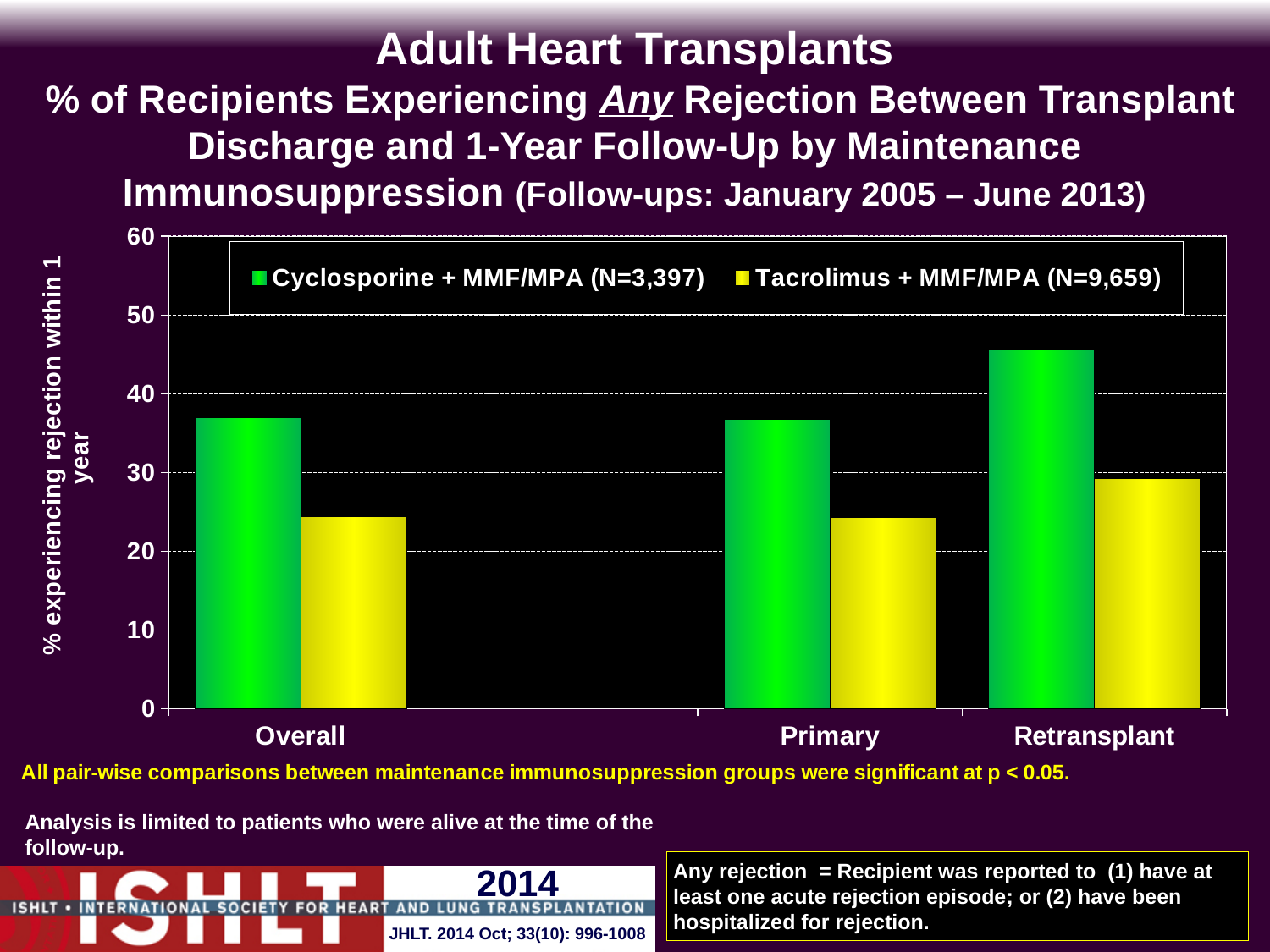
Which category has the highest value for Tacrolimus + MMF/MPA? Retransplant In the Overall group, which series has the larger value, Cyclosporine + MMF/MPA or Tacrolimus + MMF/MPA? Cyclosporine + MMF/MPA Is the value for Tacrolimus + MMF/MPA in the Overall group greater or less than 30? less How many categories are shown on the x axis? 3 What kind of chart is shown on the slide? bar chart What colour are the bars for Cyclosporine + MMF/MPA? green How many series does the legend list? 2 Which category has the highest value for Cyclosporine + MMF/MPA? Retransplant Is the value for Cyclosporine + MMF/MPA in the Primary group greater or less than 30? greater What is the N for the Tacrolimus + MMF/MPA series shown in the legend? 9,659 Is the value for Cyclosporine + MMF/MPA in the Retransplant group greater or less than 40? greater